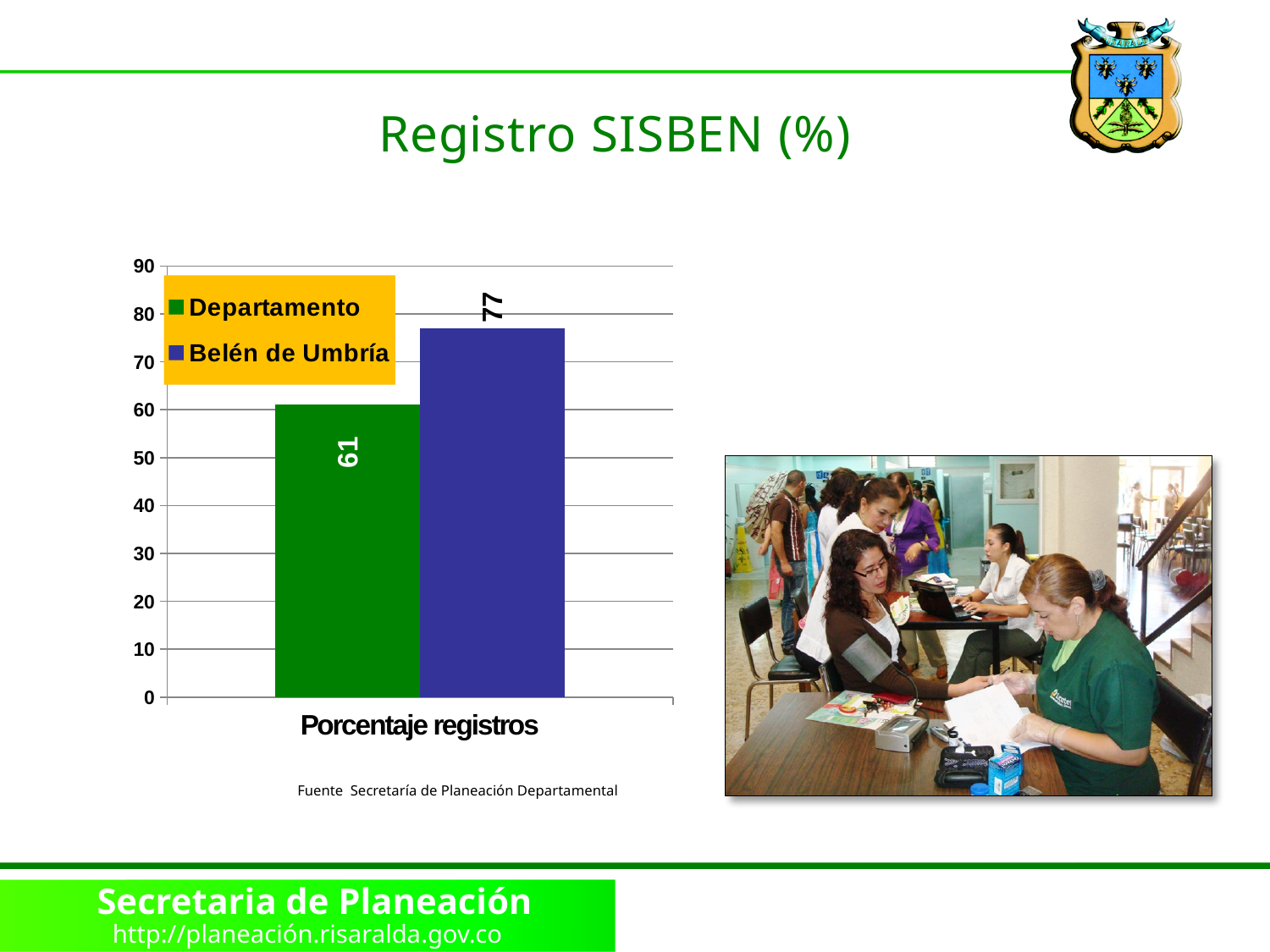
What is the value for Belén de Umbría in the Registro SISBEN (%) chart? 77 Which series has the higher value in the Registro SISBEN (%) chart? Belén de Umbría Is the value for Departamento greater or less than 70 in the Registro SISBEN (%) chart? less What colour is the Departamento bar in the Registro SISBEN (%) chart? green How many series does the legend list in the Registro SISBEN (%) chart? 2 What is the value for Departamento in the Registro SISBEN (%) chart? 61 What is the highest value shown on the y axis of the Registro SISBEN (%) chart? 90 What kind of chart is shown on the slide? bar chart What is the difference between the Belén de Umbría and Departamento values in the Registro SISBEN (%) chart? 16 Is the value for Belén de Umbría greater or less than 70 in the Registro SISBEN (%) chart? greater Which series has the lower value in the Registro SISBEN (%) chart? Departamento What is the category label on the x axis of the Registro SISBEN (%) chart? Porcentaje registros